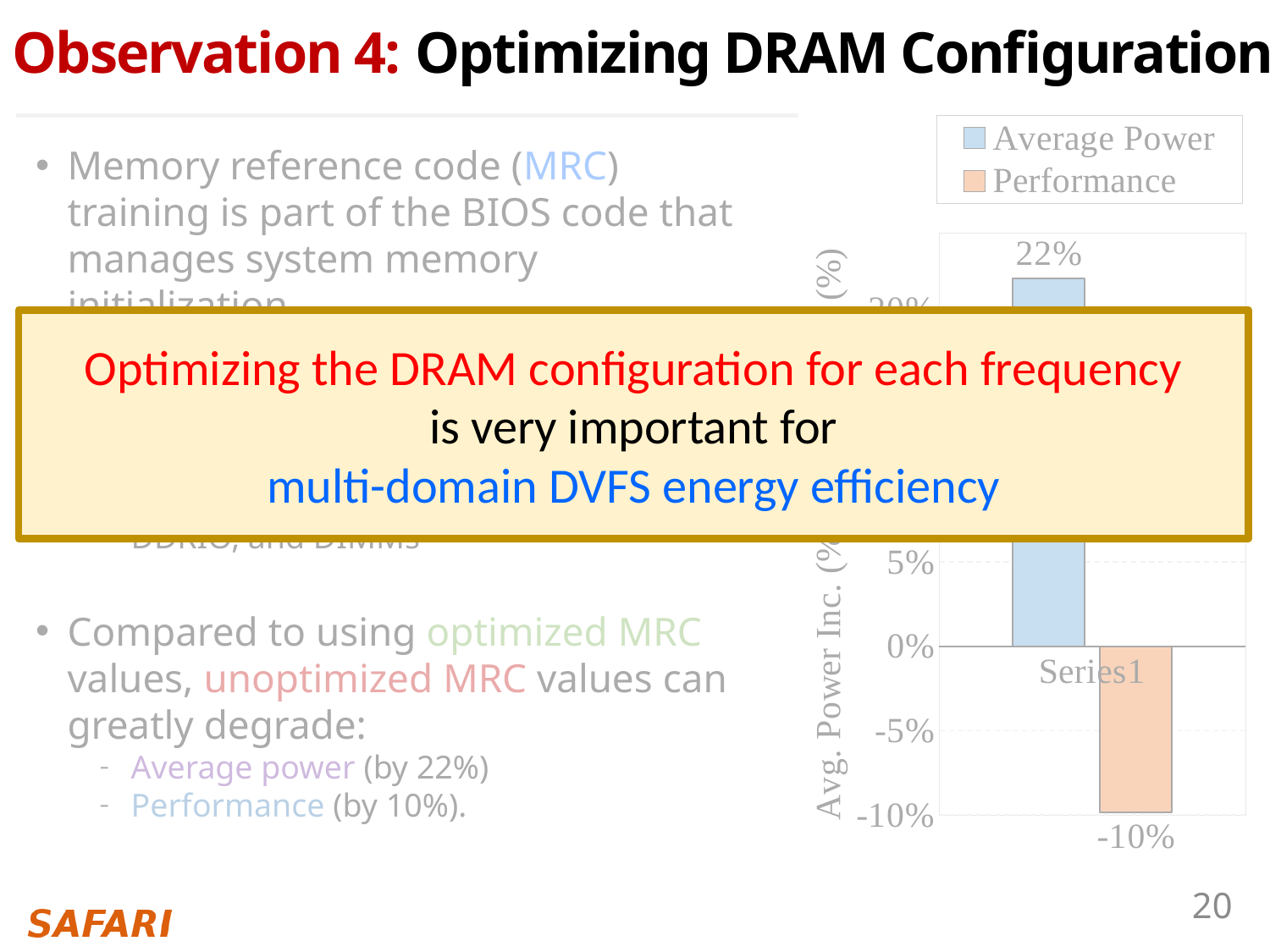
Which series has the lowest value in the chart? Performance Is the Performance value in the chart greater or less than 0%? less What is the category label shown on the x axis of the chart? Series1 What is the value of the Average Power bar in the chart? 22% What colour is the Performance bar in the chart? orange Is the Average Power value in the chart greater or less than 20%? greater How many bars are plotted in the chart? 2 Which series has the higher value in the chart, Average Power or Performance? Average Power What is the value of the Performance bar in the chart? -10% What is the difference between the Average Power value and the Performance value in the chart? 32 percentage points How many series does the chart legend list? 2 What type of chart is shown on the slide? bar chart